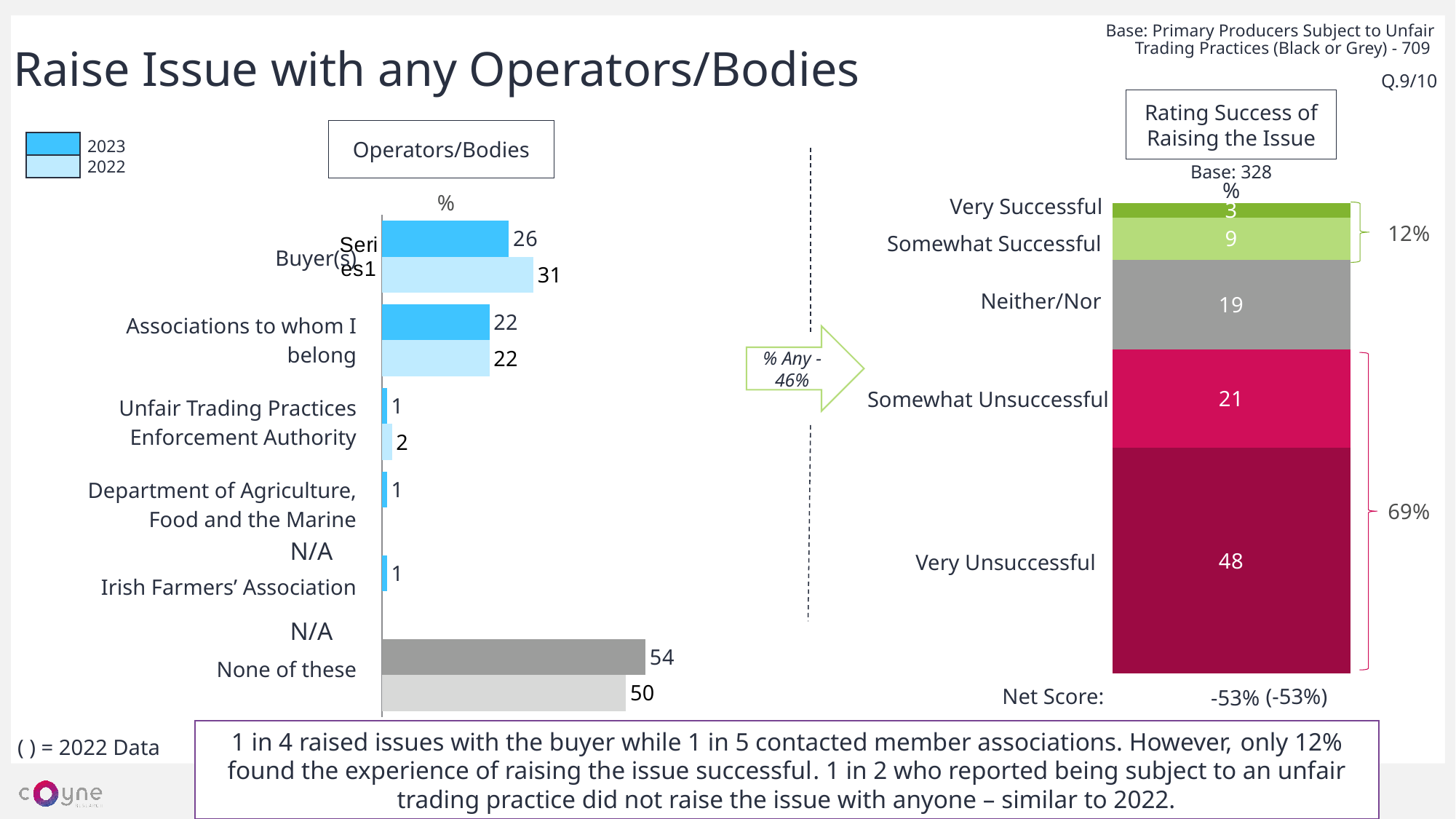
In the Rating Success of Raising the Issue chart, which rating has the lowest value? Very Successful In the Rating Success of Raising the Issue chart, what is the value for Very Unsuccessful? 48 In the Operators/Bodies chart, what is the 2023 value for None of these? 54 What kind of chart is the Operators/Bodies chart? Bar chart How many series does the legend of the Operators/Bodies chart list? 2 What is the Net Score shown under the Rating Success of Raising the Issue chart? -53% (-53%) In the Operators/Bodies chart, is the 2023 value for Associations to whom I belong larger or smaller than the 2022 value? They are equal (22) In the Rating Success of Raising the Issue chart, what is the difference between Somewhat Unsuccessful and Neither/Nor? 2 In the Operators/Bodies chart, what is the 2022 value for Buyer(s)? 31 In the Operators/Bodies chart, what is the 2023 value for Buyer(s)? 26 In the Operators/Bodies chart, which category has the highest 2023 value? None of these In the Operators/Bodies chart, what is the difference between the 2022 and 2023 values for Buyer(s)? 5